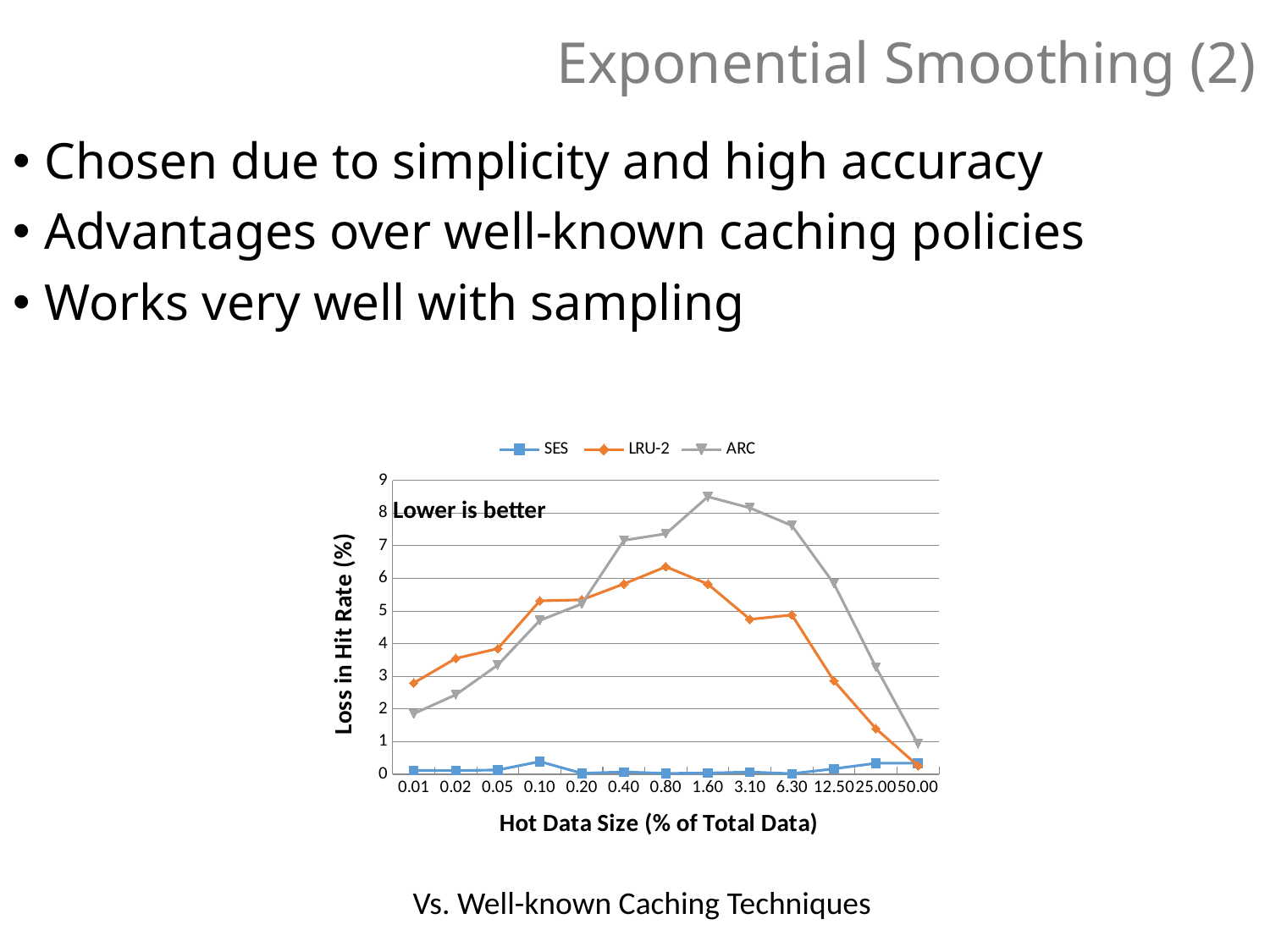
What kind of chart is shown on the slide? line chart Is the value for ARC at hot data size 1.60 greater or less than 8? greater Is the value for SES at hot data size 0.10 greater or less than 1? less How many series does the legend list? 3 At hot data size 0.01, which series has the larger loss in hit rate, LRU-2 or ARC? LRU-2 Does the ARC series rise or fall from hot data size 1.60 to 50.00? fall Is the value for LRU-2 at hot data size 0.01 greater or less than 2? greater Which series has the lowest loss in hit rate across the chart? SES Which series reaches the highest loss in hit rate anywhere on the chart? ARC At which hot data size does the ARC series reach its peak? 1.60 At hot data size 1.60, which series has the larger loss in hit rate, ARC or LRU-2? ARC How many hot data size values are plotted along the x axis? 13